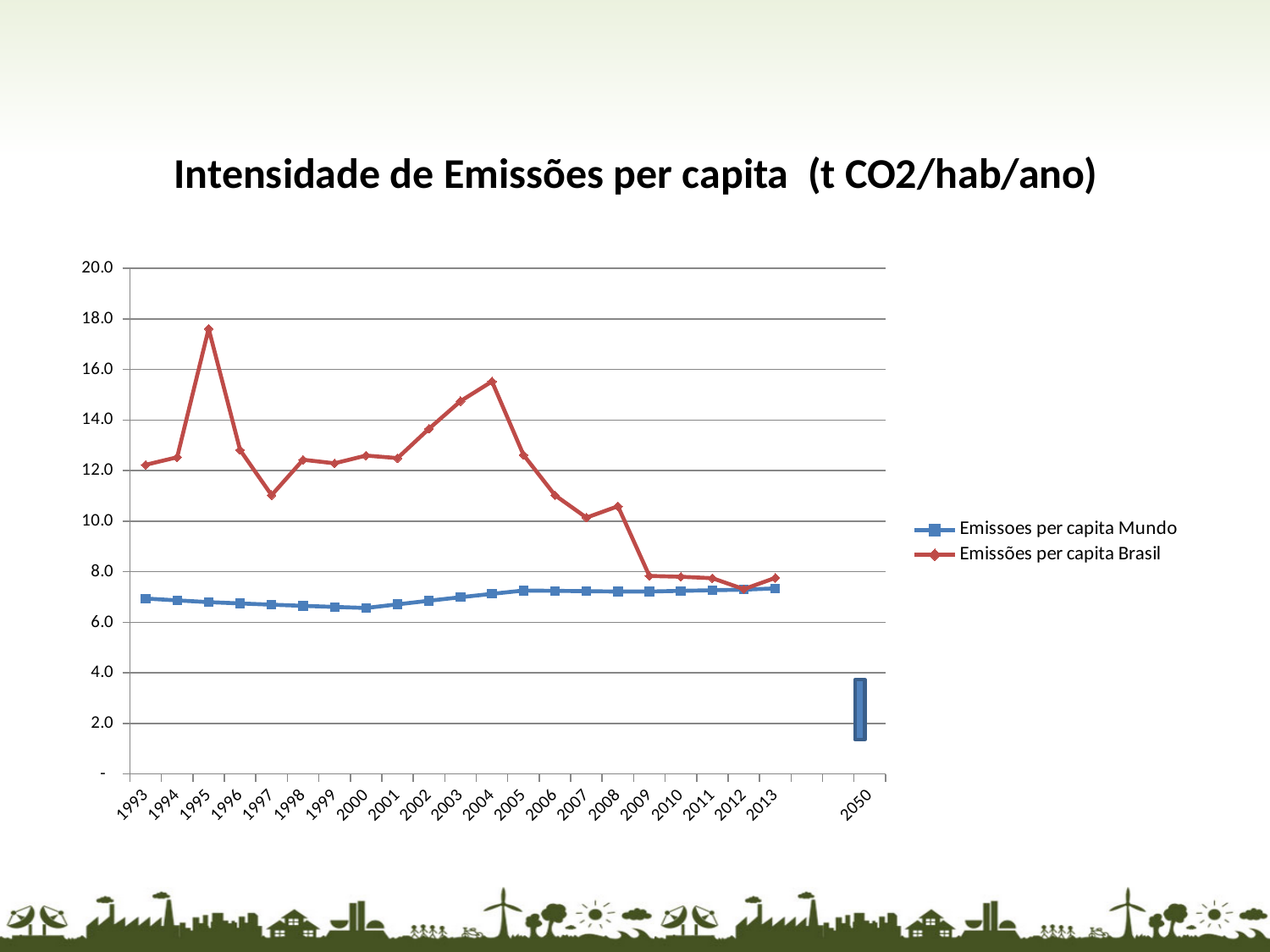
In which year does the Emissões per capita Brasil series reach its highest value? 1995 Is the value for Emissões per capita Brasil in 1995 greater or less than 16.0? greater How many yearly data points does the Emissões per capita Brasil line have (from 1993 to 2013)? 21 What kind of chart is shown on the slide? line chart How many series does the legend list? 2 Does the Emissões per capita Brasil series rise or fall between 2004 and 2009? fall Is the value for Emissões per capita Brasil in 2004 greater or less than 14.0? greater Is the value for Emissões per capita Brasil in 2009 greater or less than 10.0? less What is the title of the chart? Intensidade de Emissões per capita (t CO2/hab/ano) In 2004, which series has the larger value: Emissoes per capita Mundo or Emissões per capita Brasil? Emissões per capita Brasil